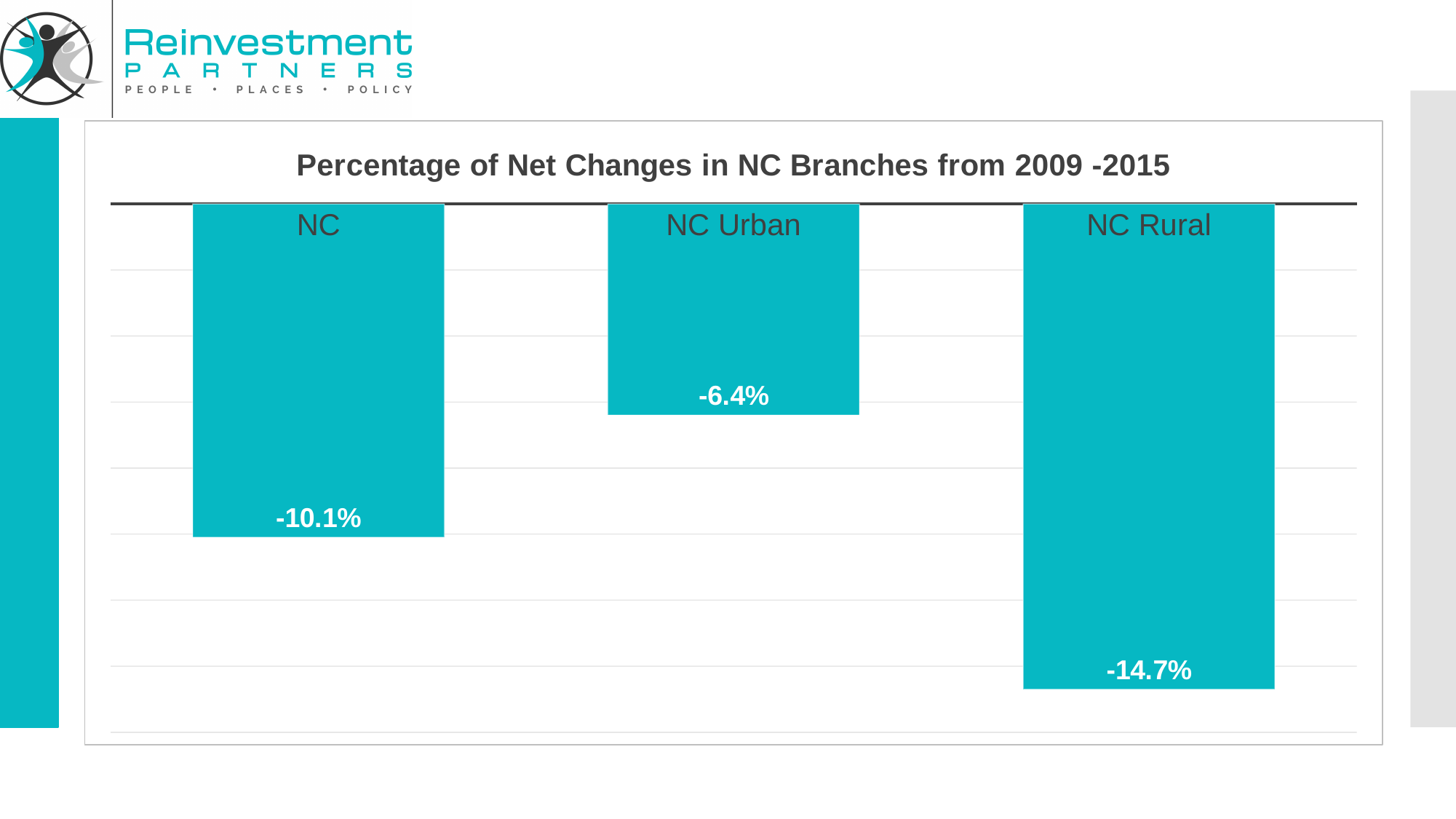
What is the value for NC? -10.1% What kind of chart is shown on the slide? Bar chart By how many percentage points does the decline for NC Rural exceed the decline for NC Urban? 8.3 percentage points Which had a larger percentage decline in branches, NC or NC Urban? NC What is the value for NC Rural? -14.7% By how many percentage points does the decline for NC Rural exceed the decline for NC? 4.6 percentage points Which category shows the smallest percentage decline in branches? NC Urban How many categories are shown in the chart? 3 What is the title of the chart? Percentage of Net Changes in NC Branches from 2009 -2015 Which category shows the largest percentage decline in branches? NC Rural Are all the values in the chart negative or positive? Negative What is the value for NC Urban? -6.4%